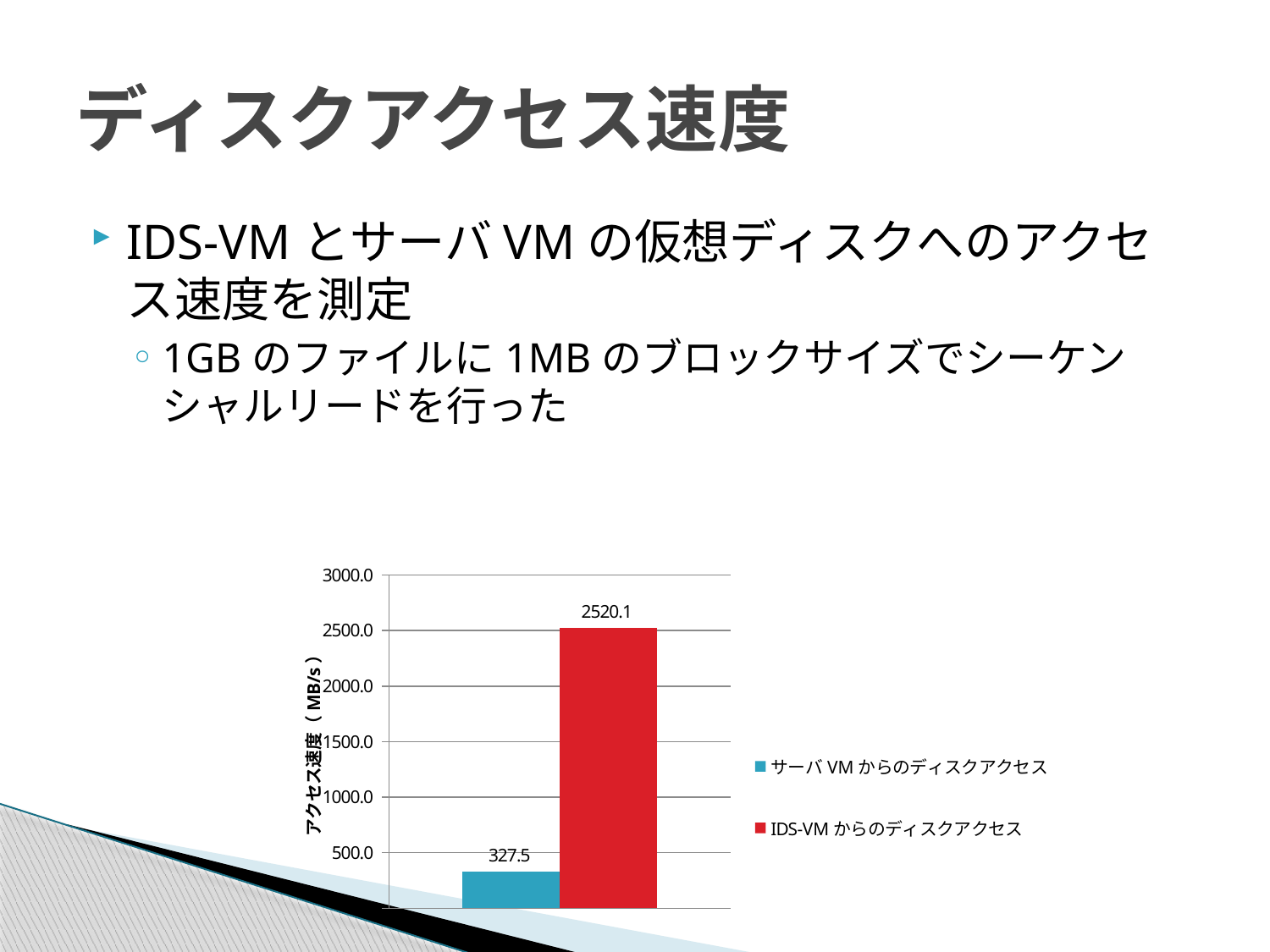
Is the value for サーバ VM からのディスクアクセス greater or less than 500.0? less Which series has the highest value? IDS-VM からのディスクアクセス What is the difference between the IDS-VM からのディスクアクセス value and the サーバ VM からのディスクアクセス value? 2192.6 What kind of chart is shown on the slide? Bar chart Is the value for IDS-VM からのディスクアクセス greater or less than 2000.0? greater How many bars are plotted in the chart? 2 Which series has the lowest value? サーバ VM からのディスクアクセス What is the value for サーバ VM からのディスクアクセス? 327.5 What is the label of the vertical axis? アクセス速度（MB/s） Which series has the higher value, サーバ VM からのディスクアクセス or IDS-VM からのディスクアクセス? IDS-VM からのディスクアクセス How many series does the legend list? 2 What is the value for IDS-VM からのディスクアクセス? 2520.1